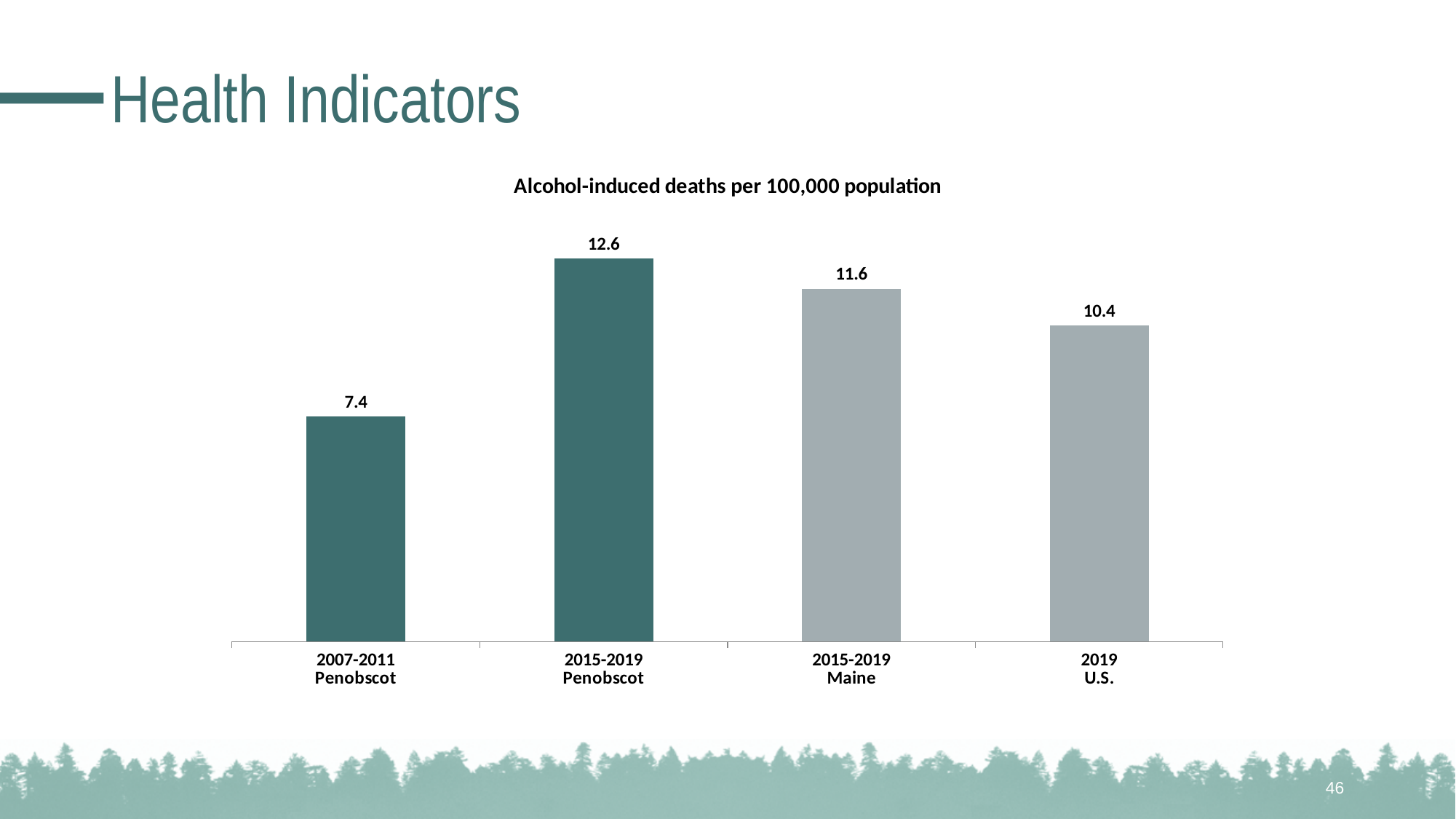
What is the value for 2015-2019 Maine? 11.6 What is the difference between the 2015-2019 Penobscot value and the 2007-2011 Penobscot value? 5.2 What is the title of the chart? Alcohol-induced deaths per 100,000 population Which category has the highest value? 2015-2019 Penobscot How many bars are shown in the chart? 4 What is the value for 2015-2019 Penobscot? 12.6 What is the value for 2019 U.S.? 10.4 Which category has the lowest value? 2007-2011 Penobscot What is the difference between the 2015-2019 Maine value and the 2019 U.S. value? 1.2 Which is larger, the value for 2015-2019 Penobscot or the value for 2015-2019 Maine? 2015-2019 Penobscot What is the value for 2007-2011 Penobscot? 7.4 What kind of chart is shown on the slide? Bar chart